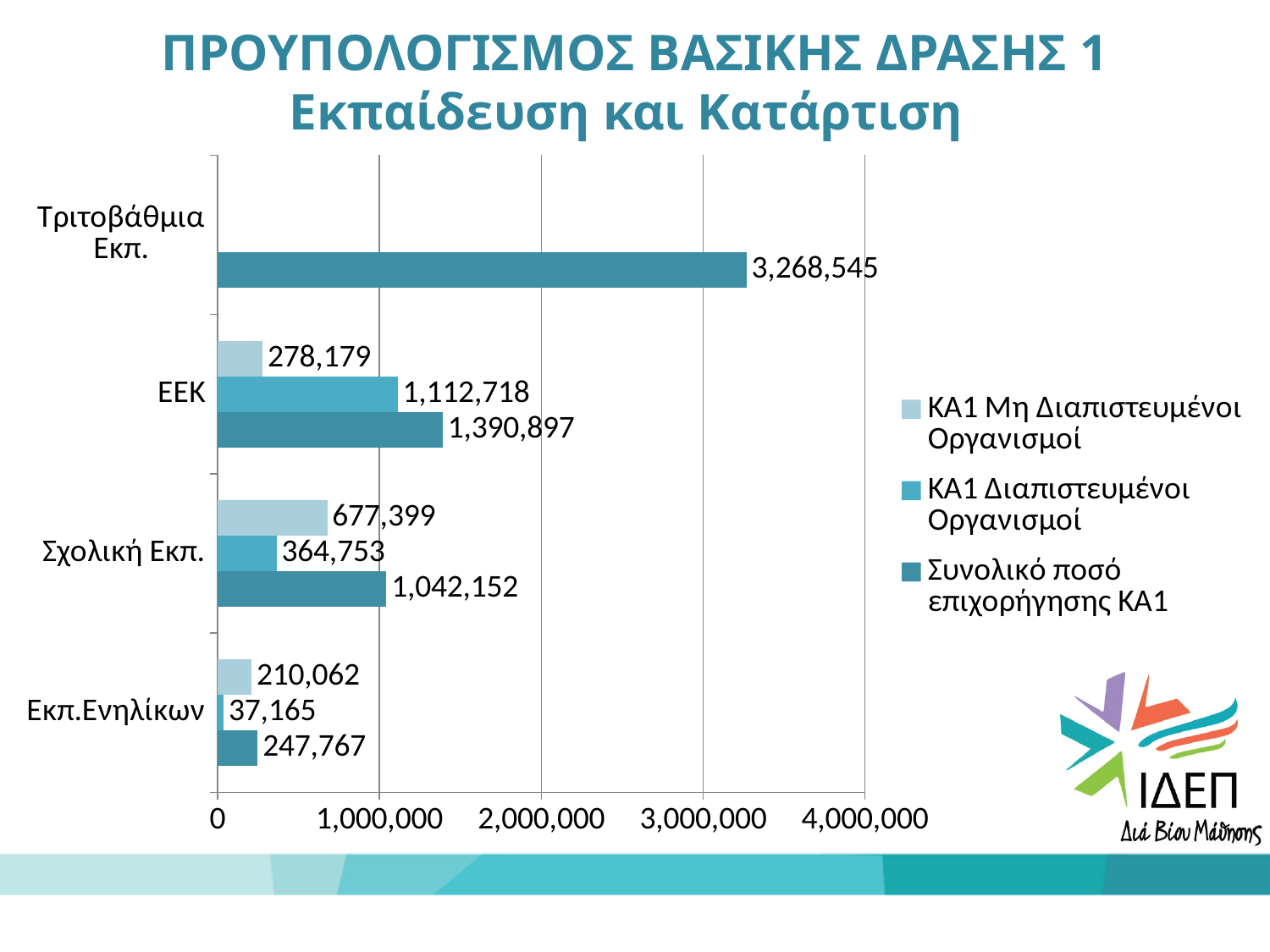
For Σχολική Εκπ., which is larger: ΚΑ1 Μη Διαπιστευμένοι Οργανισμοί or ΚΑ1 Διαπιστευμένοι Οργανισμοί? ΚΑ1 Μη Διαπιστευμένοι Οργανισμοί What is the difference between ΚΑ1 Διαπιστευμένοι Οργανισμοί and ΚΑ1 Μη Διαπιστευμένοι Οργανισμοί for ΕΕΚ? 834,539 What is the value of Συνολικό ποσό επιχορήγησης ΚΑ1 for Τριτοβάθμια Εκπ.? 3,268,545 What is the value of ΚΑ1 Μη Διαπιστευμένοι Οργανισμοί for Σχολική Εκπ.? 677,399 Which category has the highest Συνολικό ποσό επιχορήγησης ΚΑ1? Τριτοβάθμια Εκπ. How many categories are shown on the y axis of the chart? 4 Which category has the lowest Συνολικό ποσό επιχορήγησης ΚΑ1? Εκπ.Ενηλίκων Is the Συνολικό ποσό επιχορήγησης ΚΑ1 for Τριτοβάθμια Εκπ. greater or less than 3,000,000? greater What is the value of ΚΑ1 Διαπιστευμένοι Οργανισμοί for Εκπ.Ενηλίκων? 37,165 How many series does the legend list? 3 What kind of chart is shown on the slide? bar chart What is the value of ΚΑ1 Διαπιστευμένοι Οργανισμοί for ΕΕΚ? 1,112,718